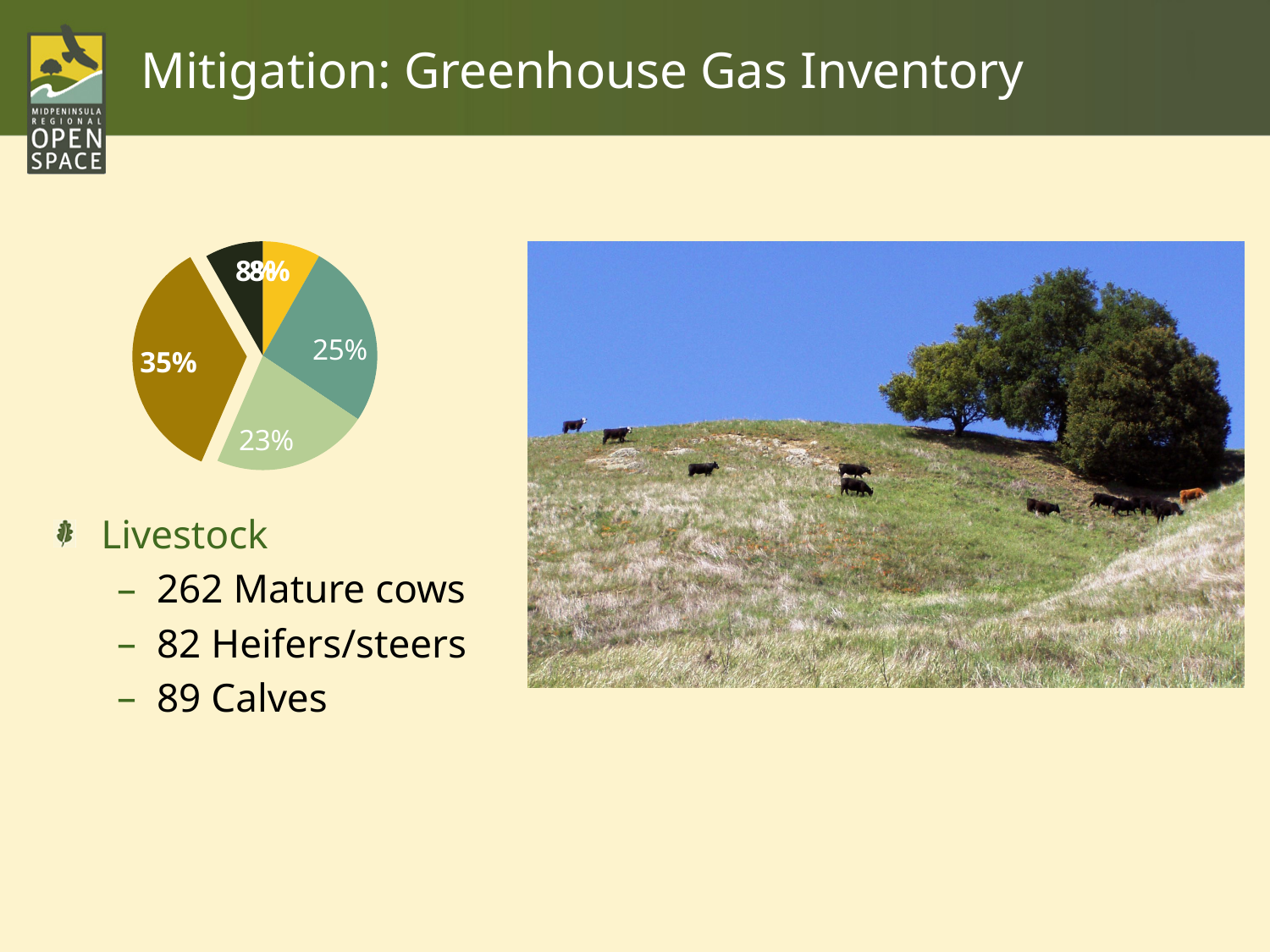
What is the percentage of the largest slice in the pie chart? 35% How many slices in the pie chart are labelled 8%? 2 What is the difference in percentage points between the largest slice (35%) and the 25% slice? 10 What is the percentage of the smallest slice in the pie chart? 8% Which is larger in the pie chart, the 25% slice or the 23% slice? The 25% slice Does the pie chart include a legend naming its slices? No How many slices does the pie chart have? 5 What is the difference in percentage points between the 25% slice and the 23% slice? 2 What kind of chart is shown on the slide? Pie chart Is the largest slice of the pie chart greater or less than 30%? greater